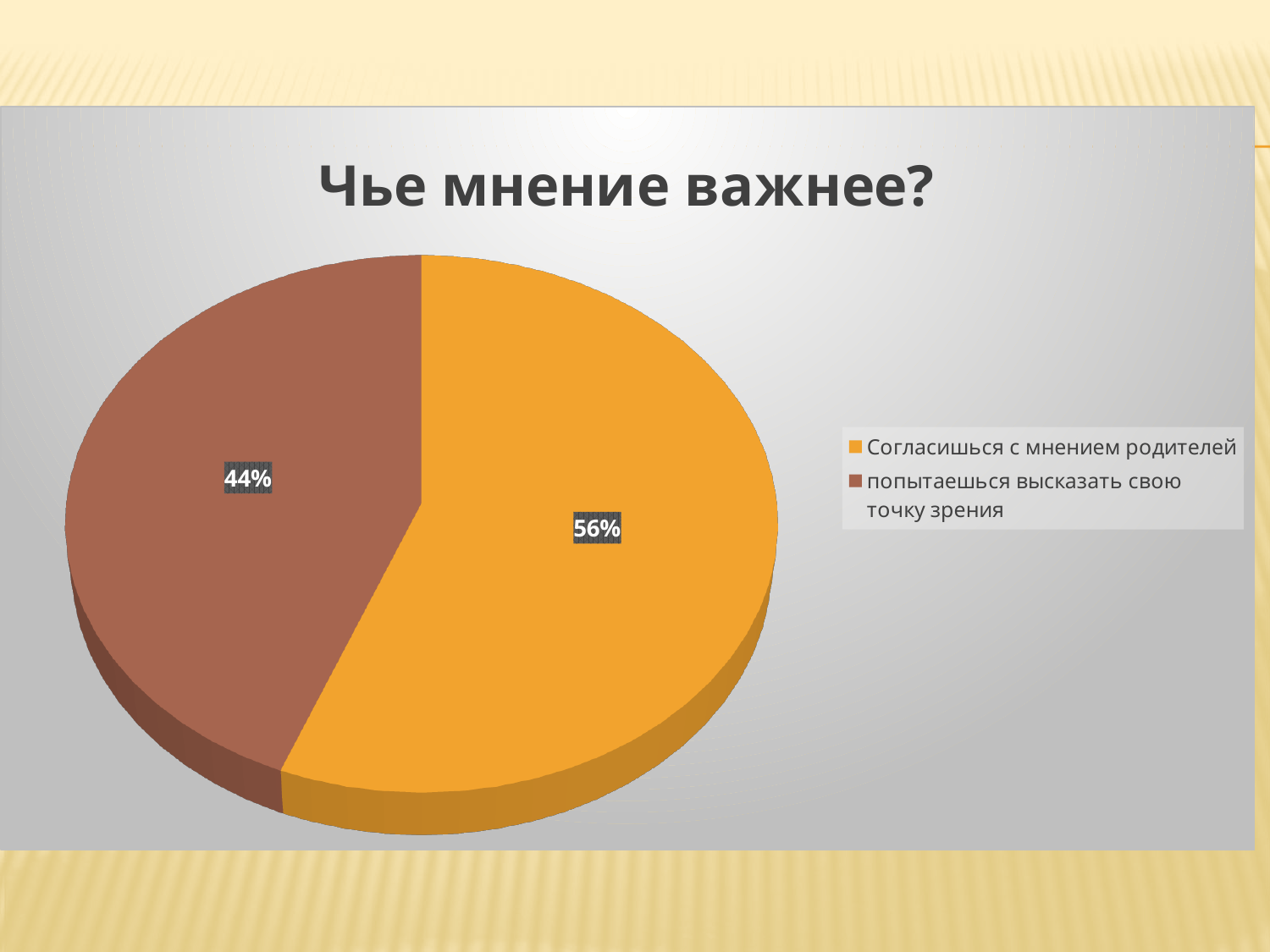
What percentage is shown for "попытаешься высказать свою точку зрения"? 44% What percentage is shown for "Согласишься с мнением родителей"? 56% Which is larger: "Согласишься с мнением родителей" or "попытаешься высказать свою точку зрения"? Согласишься с мнением родителей What is the difference in percentage points between the two slices? 12 What share of the pie does "Согласишься с мнением родителей" take? 56% Which slice is the smallest? попытаешься высказать свою точку зрения What is the title of the chart? Чье мнение важнее? What type of chart is shown on the slide? pie chart What colour is the slice for "попытаешься высказать свою точку зрения"? brown How many slices does the pie chart have? 2 How many entries does the legend list? 2 Which slice is the largest? Согласишься с мнением родителей